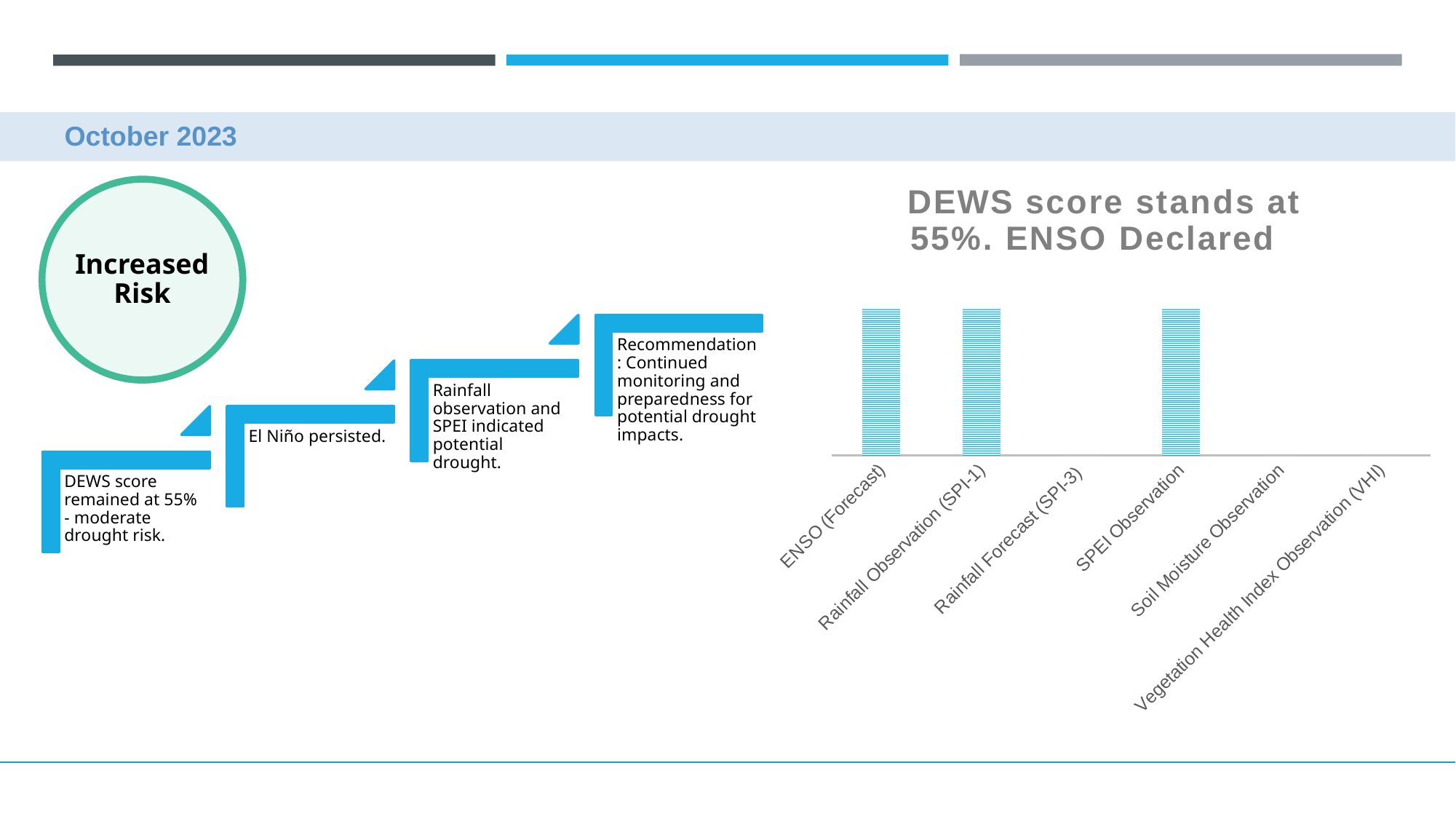
Which of the two has a larger value in the bar chart: SPEI Observation or Soil Moisture Observation? SPEI Observation Which categories in the bar chart have a visible bar? ENSO (Forecast), Rainfall Observation (SPI-1), SPEI Observation How many categories are listed on the x axis of the bar chart? 6 What is the label of the first category on the x axis of the bar chart? ENSO (Forecast) Which of the two has a larger value in the bar chart: Rainfall Observation (SPI-1) or Vegetation Health Index Observation (VHI)? Rainfall Observation (SPI-1) How many categories in the bar chart have no visible bar? 3 How many categories in the bar chart have a visible bar? 3 What kind of chart is shown on the right of the slide? bar chart What is the label of the last category on the x axis of the bar chart? Vegetation Health Index Observation (VHI) What is the title of the bar chart? DEWS score stands at 55%. ENSO Declared Which of the two has a larger value in the bar chart: ENSO (Forecast) or Rainfall Forecast (SPI-3)? ENSO (Forecast)